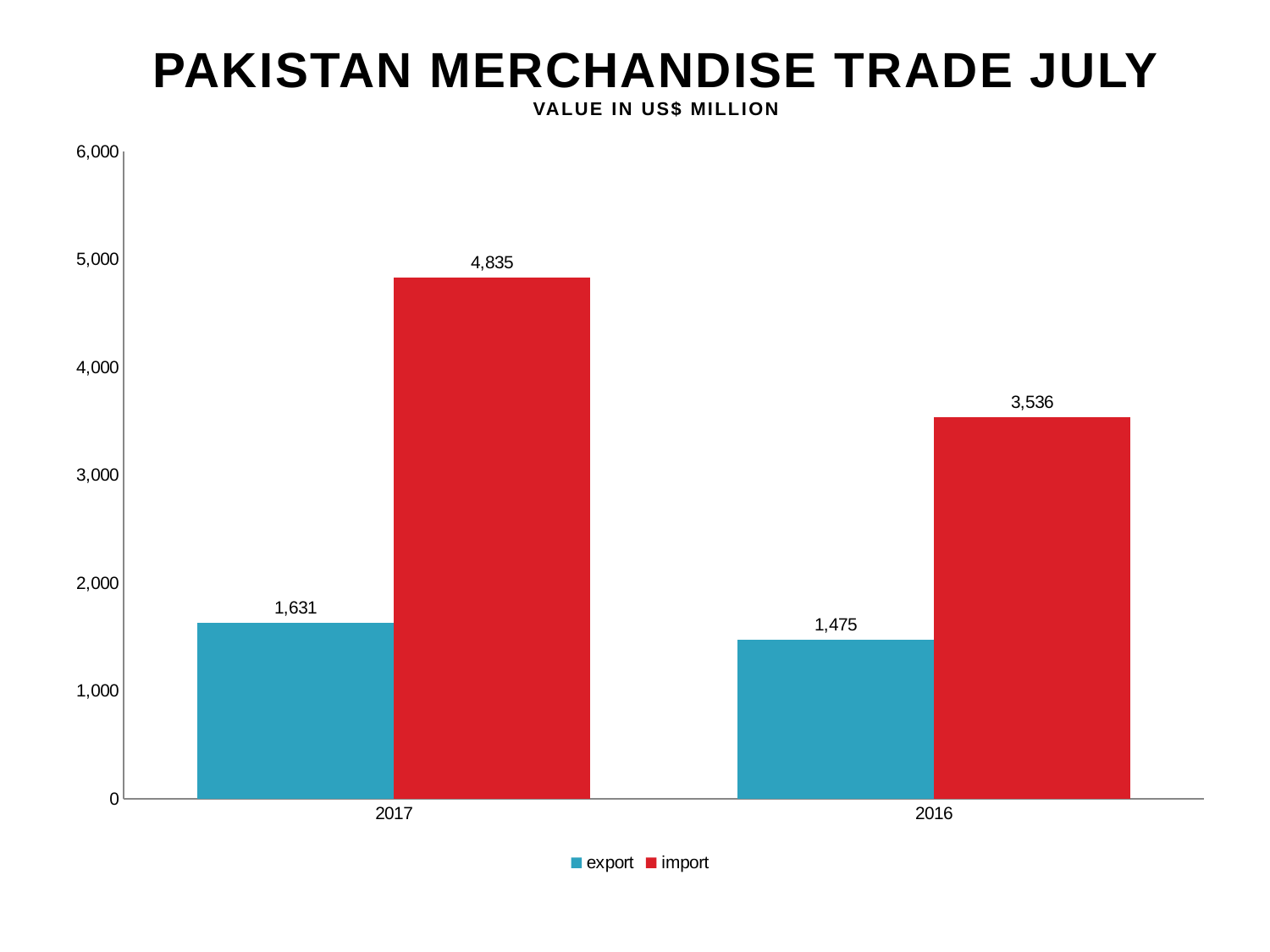
What is the difference between import and export in 2017? 3,204 What is the export value for 2016? 1,475 What is the import value for 2017? 4,835 What kind of chart is shown on the slide? Bar chart What unit are the values given in, according to the subtitle? US$ million Is the export value for 2017 larger than the export value for 2016? Yes What is the export value for 2017? 1,631 Which year has the higher import value? 2017 What is the import value for 2016? 3,536 Which year has the lower export value? 2016 What is the difference between the import values for 2017 and 2016? 1,299 How many series does the legend list? 2